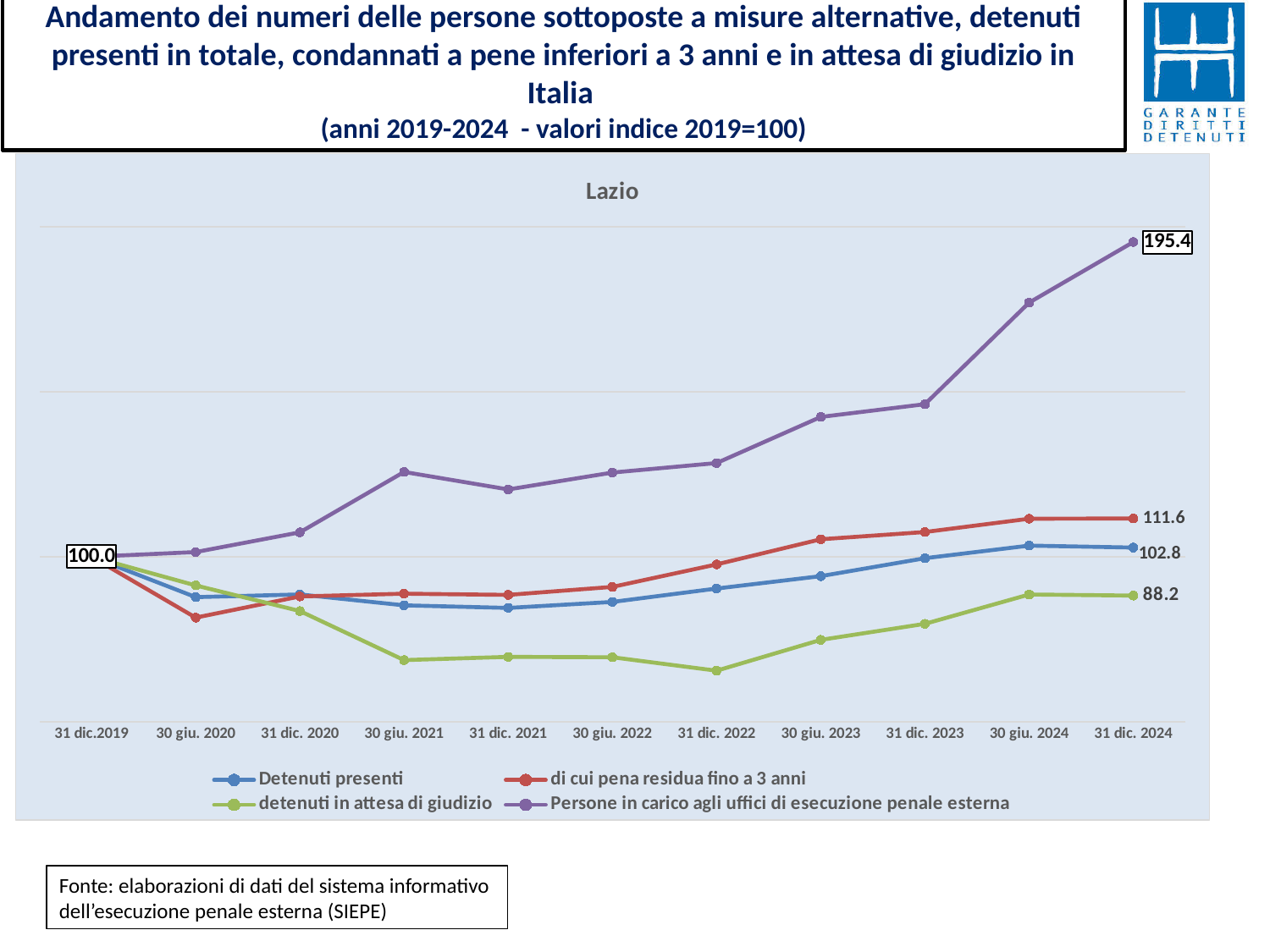
Which series has the lowest value at 31 dic. 2024? detenuti in attesa di giudizio What is the value for Detenuti presenti at 31 dic. 2024? 102.8 How many series does the legend list? 4 What is the index value shown for all series at 31 dic.2019? 100.0 What is the value for di cui pena residua fino a 3 anni at 31 dic. 2024? 111.6 What is the value for detenuti in attesa di giudizio at 31 dic. 2024? 88.2 What is the value for Persone in carico agli uffici di esecuzione penale esterna at 31 dic. 2024? 195.4 What kind of chart is shown on the slide? Line chart Which series has the highest value at 31 dic. 2024? Persone in carico agli uffici di esecuzione penale esterna What is the difference between the values of Persone in carico agli uffici di esecuzione penale esterna and detenuti in attesa di giudizio at 31 dic. 2024? 107.2 How many time points are shown on the x axis? 11 At 31 dic. 2024, which is larger: Detenuti presenti or detenuti in attesa di giudizio? Detenuti presenti